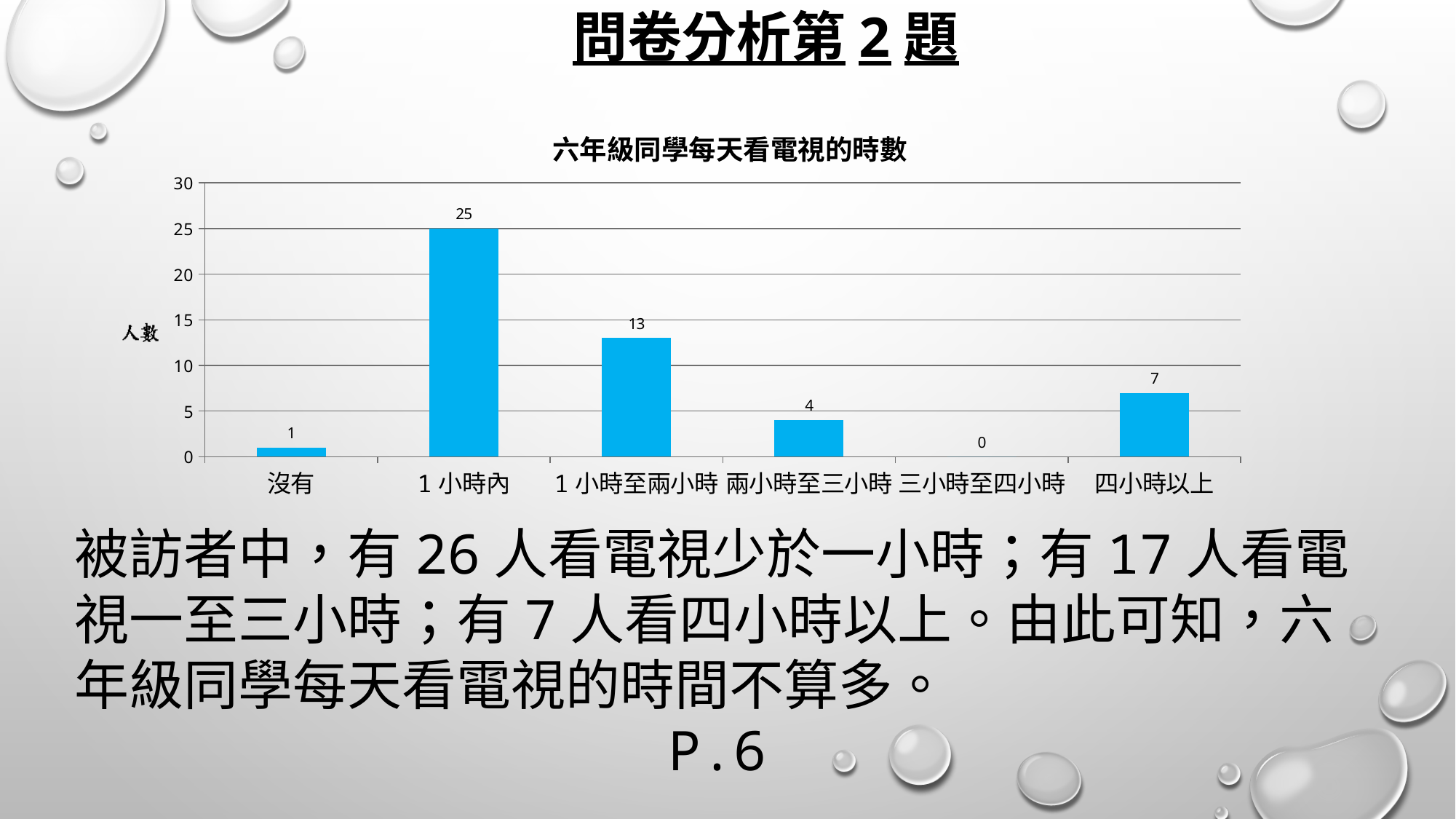
What is the value for 四小時以上? 7 Which category has the highest value? 1 小時內 What is the label on the vertical axis? 人數 What is the value for 三小時至四小時? 0 What is the difference between the values for 1 小時內 and 1 小時至兩小時? 12 What is the title of the chart? 六年級同學每天看電視的時數 Is the value for 1 小時至兩小時 greater or less than 10? greater Which is larger, the value for 兩小時至三小時 or the value for 四小時以上? 四小時以上 What kind of chart is this? bar chart Which category has the lowest value? 三小時至四小時 What is the value for 1 小時內? 25 How many categories are shown on the x axis? 6